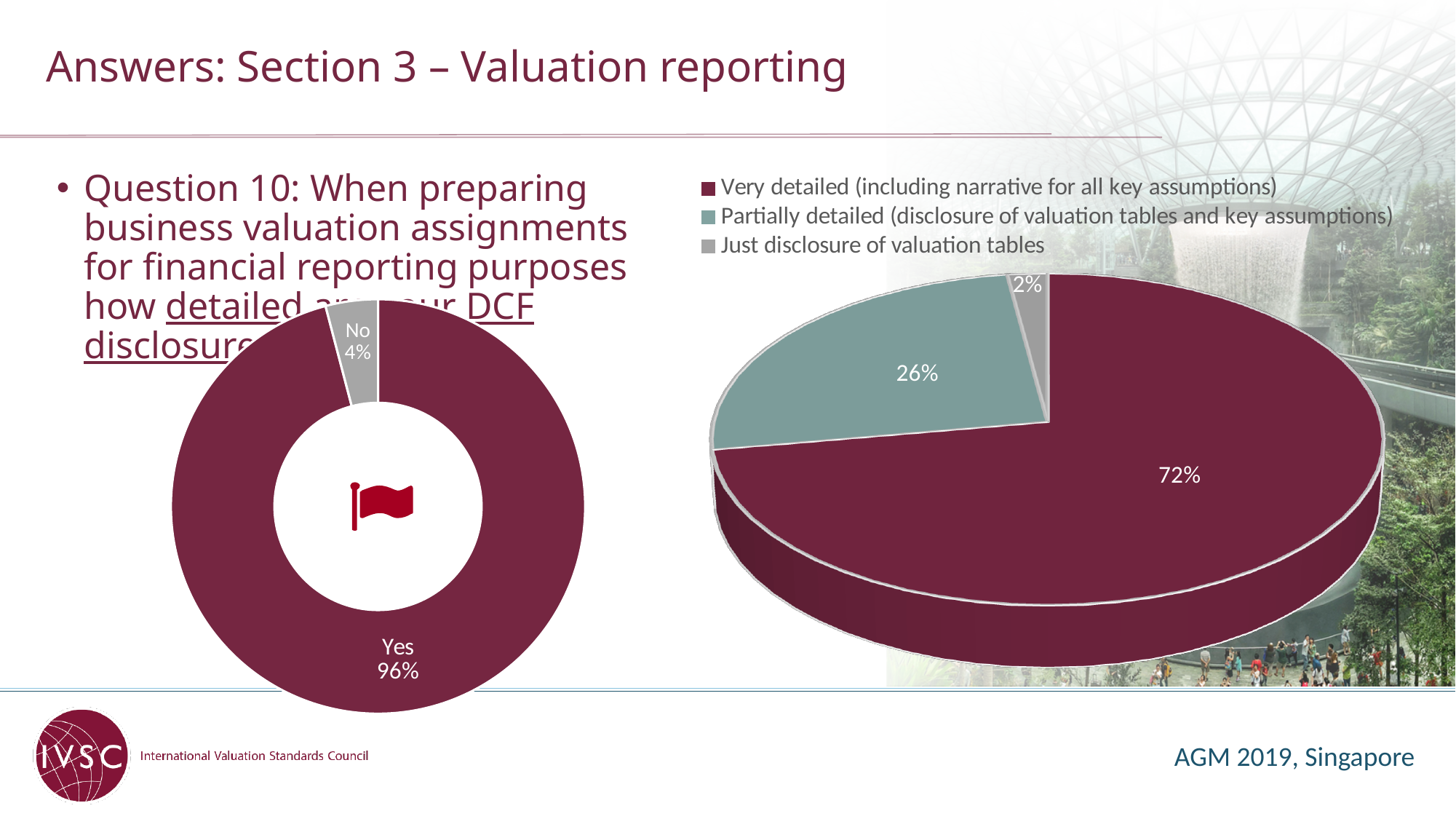
What kind of chart is shown on the right of the slide? Pie chart How many entries does the legend of the pie chart on the right list? 3 On the pie chart on the right, which category has the smallest share? Just disclosure of valuation tables On the doughnut chart on the left, which is larger, 'Yes' or 'No'? Yes On the pie chart on the right, what is the difference in percentage points between the 'Very detailed' and 'Partially detailed' slices? 46 On the doughnut chart on the left, what percentage is labelled for 'Yes'? 96% On the doughnut chart on the left, what percentage is labelled for 'No'? 4% How many slices does the doughnut chart on the left have? 2 On the pie chart on the right, which category has the largest share? Very detailed (including narrative for all key assumptions) On the pie chart on the right, what share is labelled for 'Very detailed (including narrative for all key assumptions)'? 72% On the pie chart on the right, what share is labelled for 'Just disclosure of valuation tables'? 2% On the pie chart on the right, what share is labelled for 'Partially detailed (disclosure of valuation tables and key assumptions)'? 26%